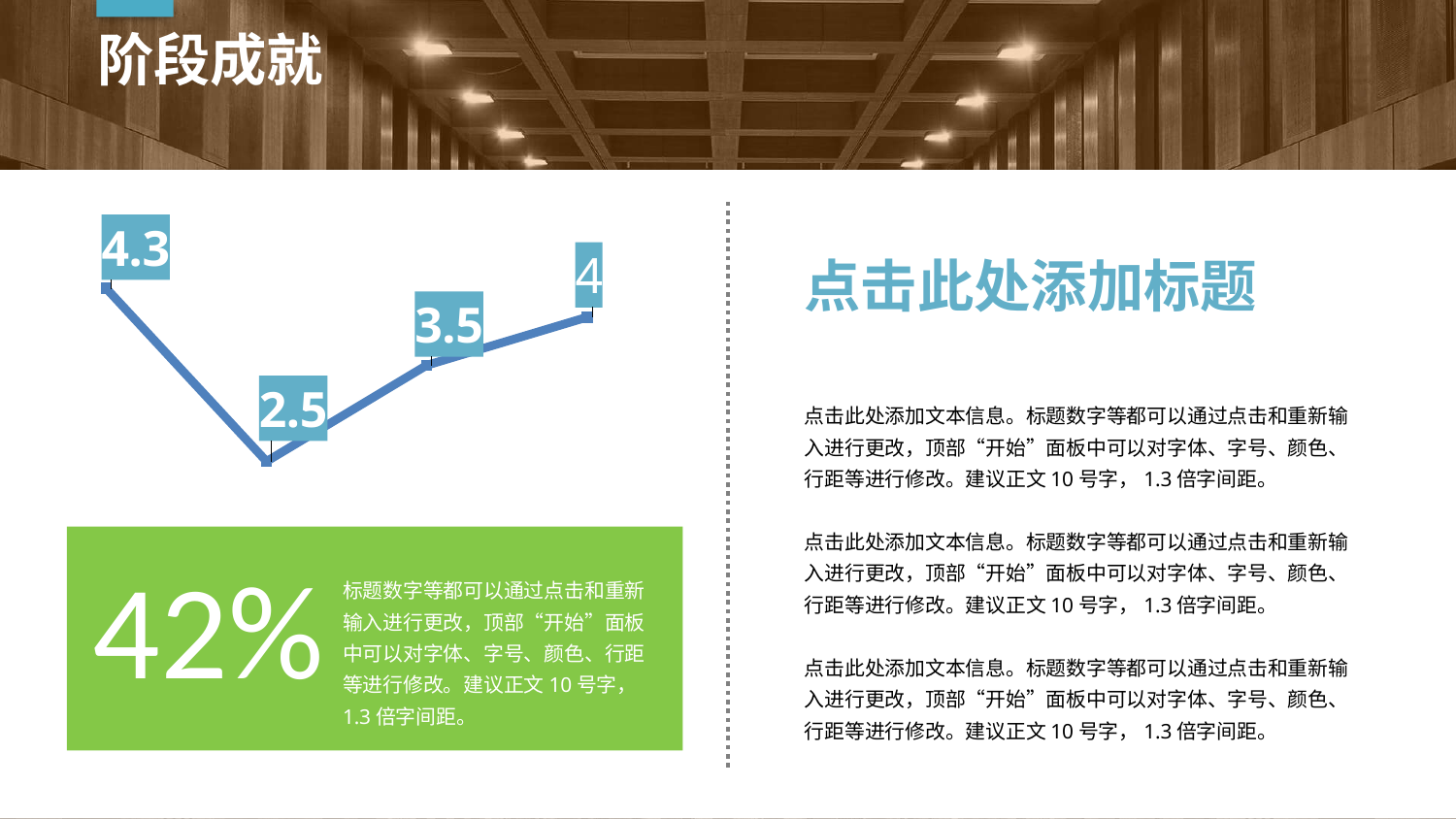
Which is larger on the line chart, the third point or the fourth point? the fourth point (4) Which point on the line chart has the highest value? the first point (4.3) What colour is the line in the line chart? blue From the second point to the last point, do the values on the line chart rise or fall? rise What is the value of the first (leftmost) point on the line chart? 4.3 What is the value of the second point on the line chart? 2.5 What is the difference between the first point (4.3) and the second point (2.5) on the line chart? 1.8 Which point on the line chart has the lowest value? the second point (2.5) What is the value of the last (rightmost) point on the line chart? 4 How many data points are plotted on the line chart? 4 What is the value of the third point on the line chart? 3.5 What kind of chart is shown on the left of the slide? line chart